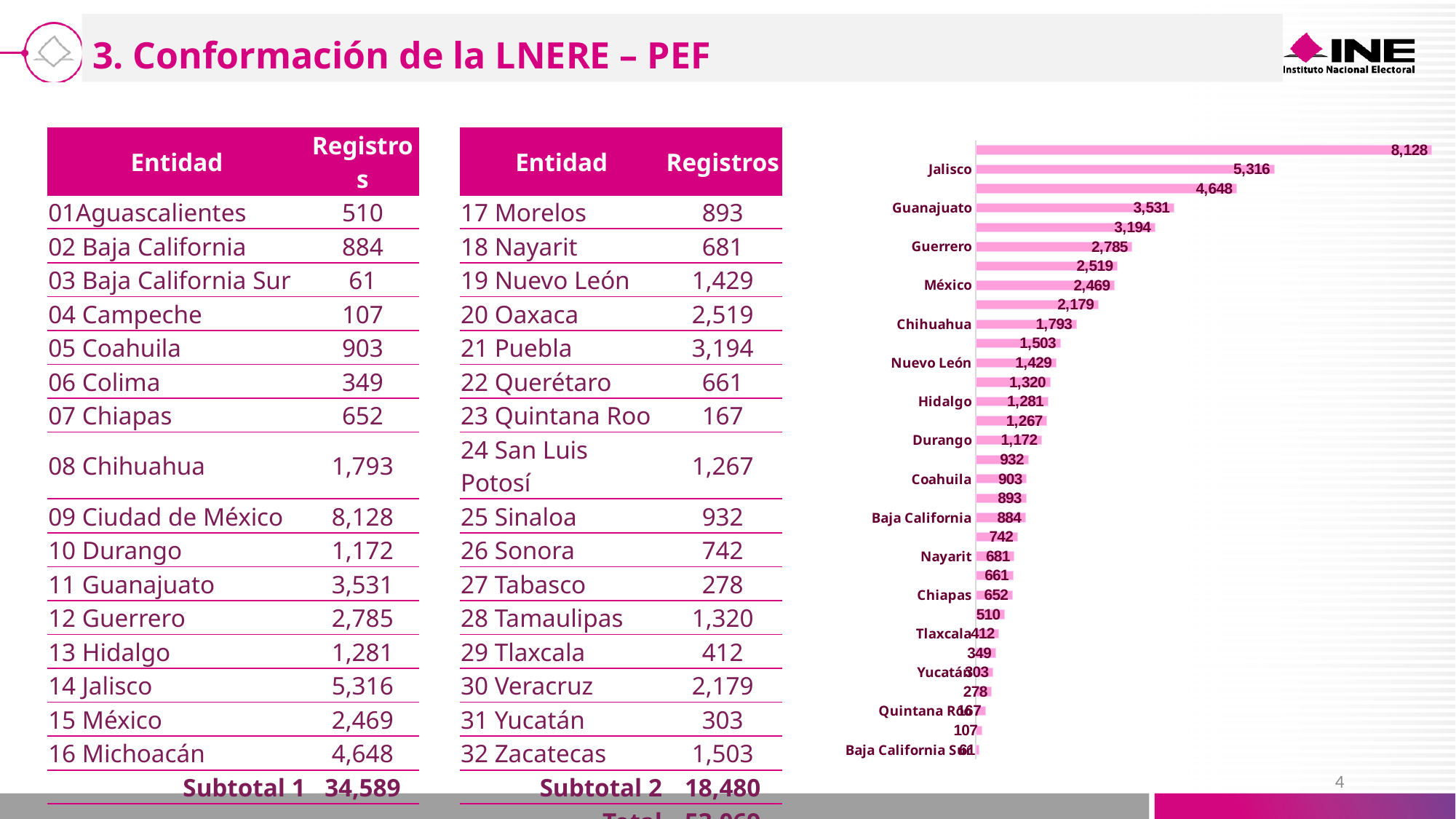
In the bar chart, do the bar values increase or decrease going from the top of the chart to the bottom? decrease In the bar chart, what is the value for Chihuahua? 1,793 In the bar chart, which labelled category has the lowest value? Baja California Sur In the bar chart, what is the value for Guanajuato? 3,531 In the bar chart, which is larger, the value for Nuevo León or the value for Hidalgo? Nuevo León What is the largest value labelled on any bar in the chart? 8,128 How many bars are plotted in the bar chart? 32 In the bar chart, what is the value for Jalisco? 5,316 In the bar chart, what is the value for Baja California Sur? 61 In the bar chart, what is the difference between the values for Guerrero and México? 316 In the bar chart, what is the difference between the values for Coahuila and Baja California? 19 What kind of chart is shown on the right side of the slide? bar chart